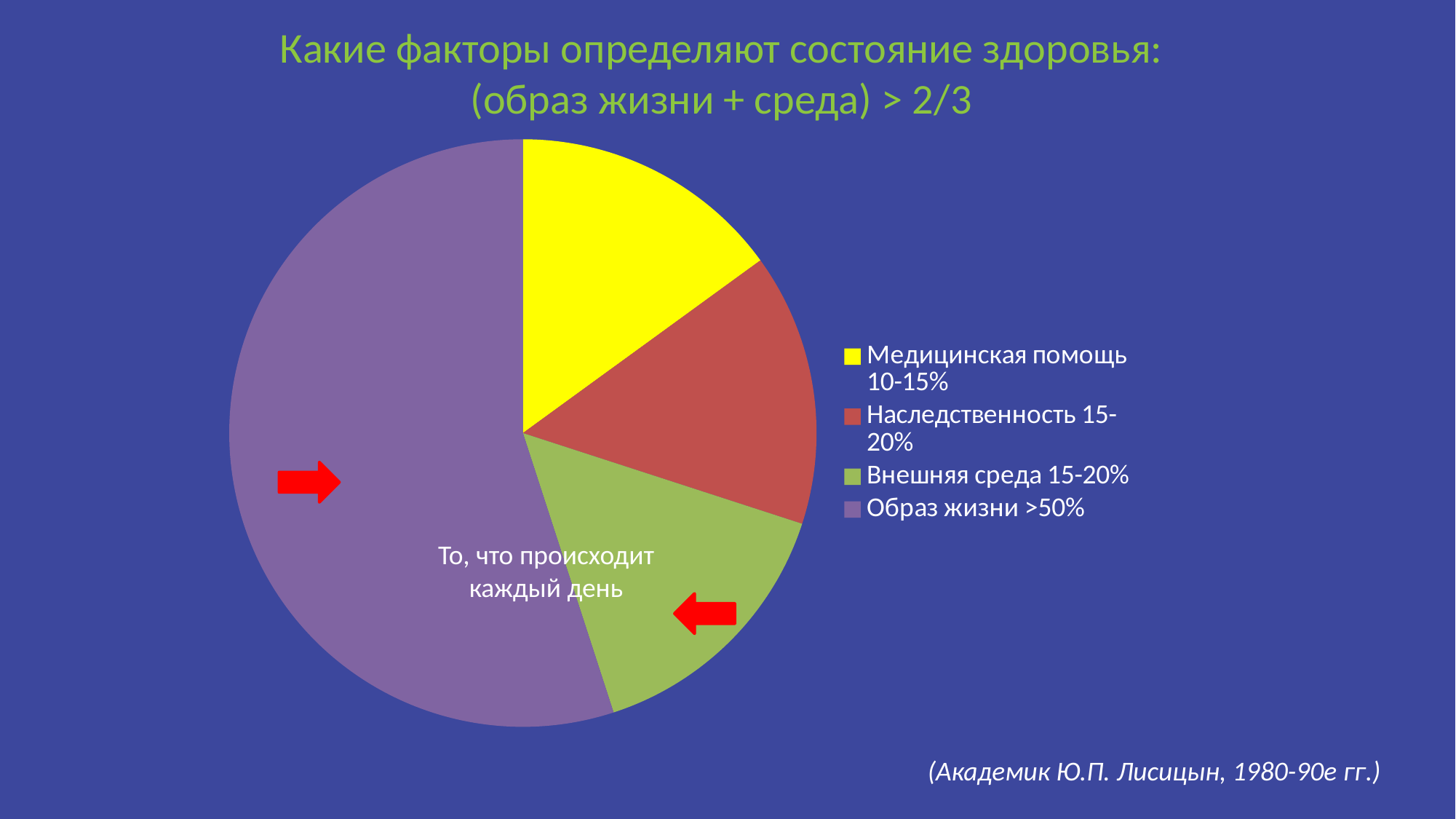
What colour is the slice for Медицинская помощь in the pie chart? yellow Is the share of the pie for Образ жизни greater or less than 50%? greater Which slice is larger: Образ жизни or Медицинская помощь? Образ жизни How many slices does the pie chart have? 4 Which category has the largest slice of the pie chart? Образ жизни >50% What percentage range does the legend give for Медицинская помощь? 10-15% What share does the legend give for Образ жизни? >50% What kind of chart is shown on the slide? pie chart What percentage range does the legend give for Внешняя среда? 15-20% What percentage range does the legend give for Наследственность? 15-20% How many entries does the legend of the pie chart list? 4 What colour is the slice for Образ жизни in the pie chart? purple